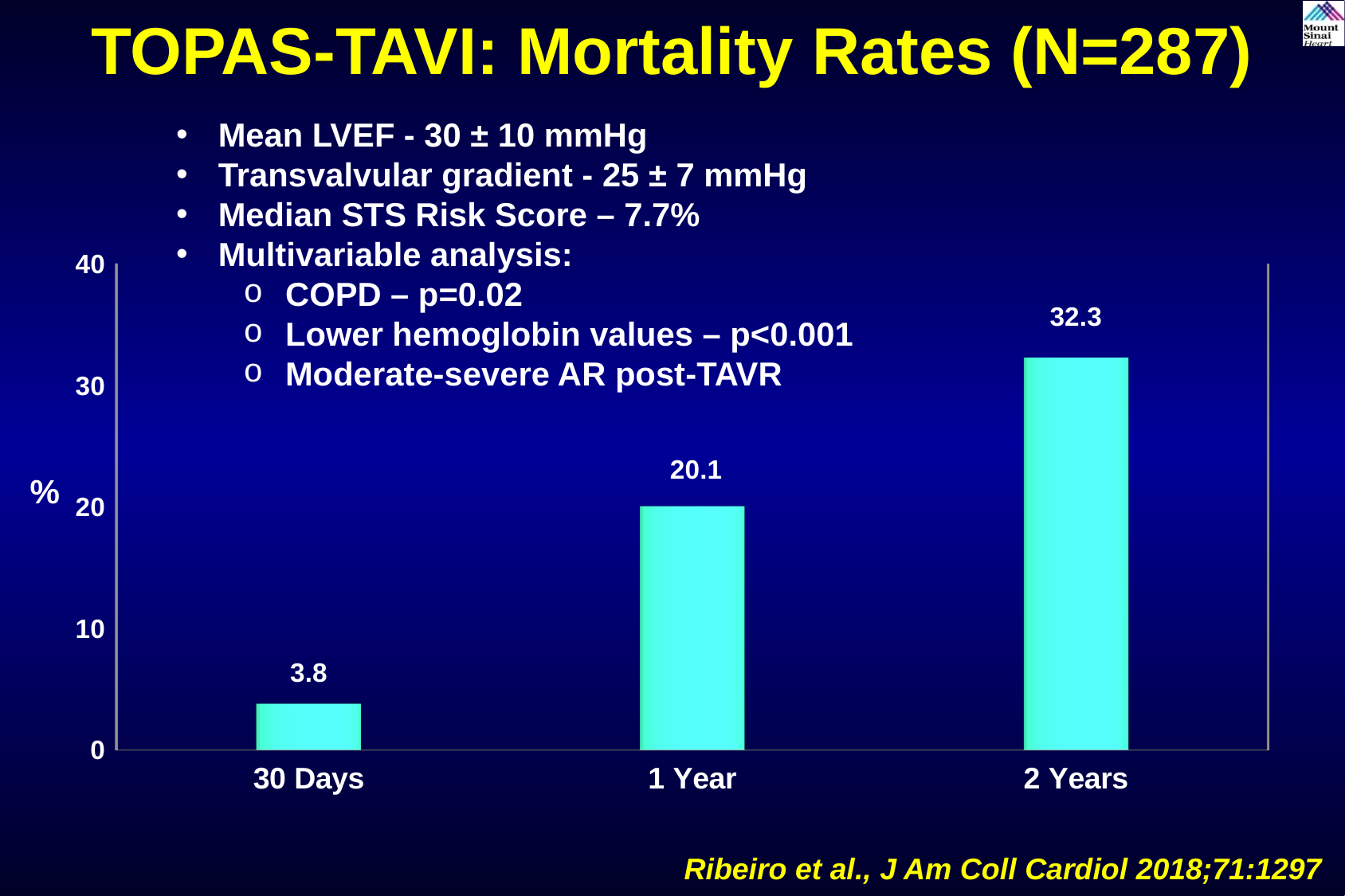
What is the mortality rate at 2 Years? 32.3 What is the mortality rate at 30 Days? 3.8 Do the mortality rates rise or fall from 30 Days to 2 Years? rise What is the mortality rate at 1 Year? 20.1 Which time point has the highest mortality rate? 2 Years What is the difference between the mortality rate at 2 Years and at 1 Year? 12.2 Which time point has the lowest mortality rate? 30 Days What kind of chart is shown on the slide? bar chart What is the difference between the mortality rate at 1 Year and at 30 Days? 16.3 Is the mortality rate at 2 Years greater or less than 30? greater How many time points are shown on the chart? 3 Which is larger, the mortality rate at 1 Year or at 30 Days? 1 Year